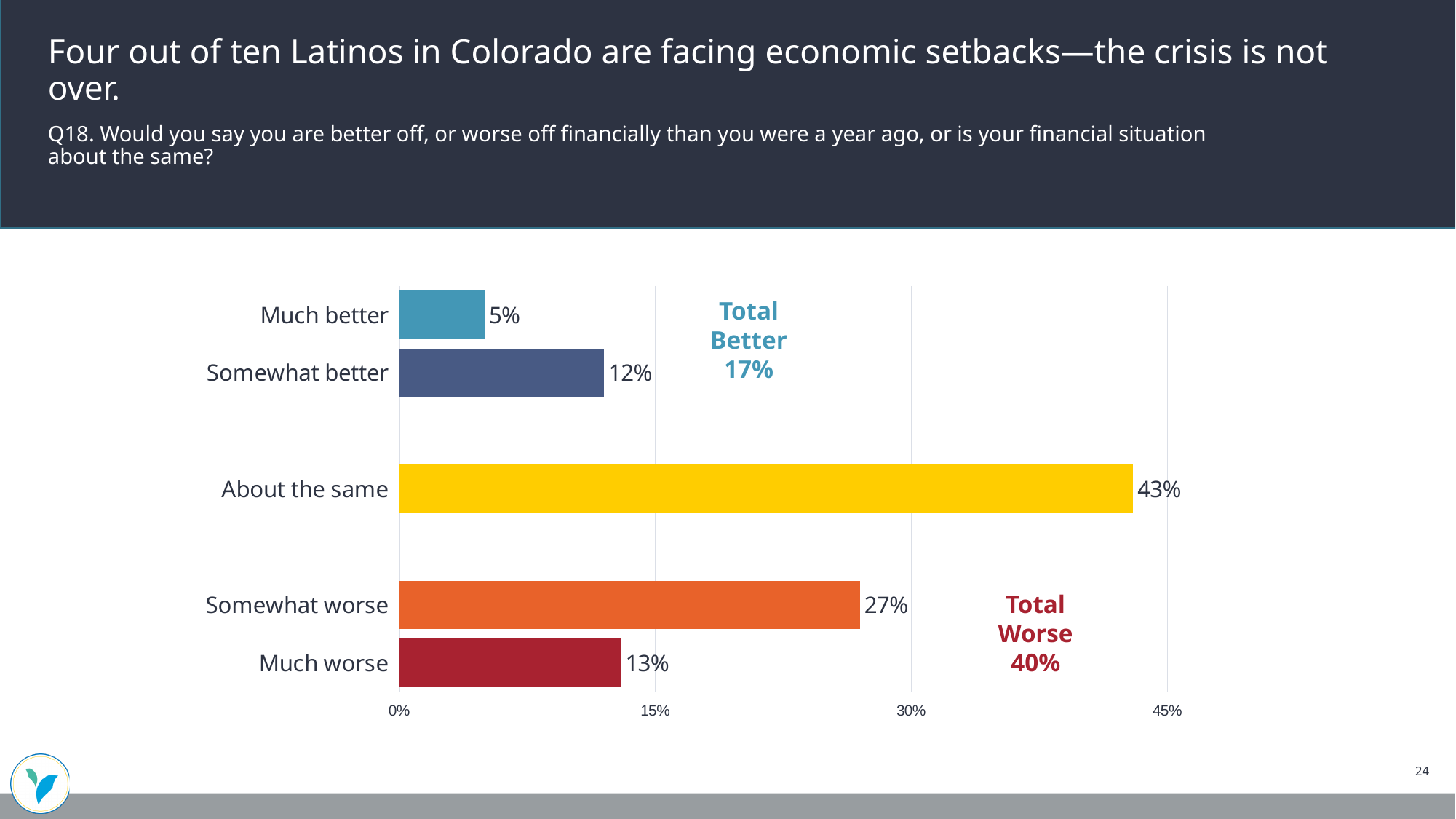
What is the 'Total Worse' percentage annotated on the chart? 40% How many categories are shown in the chart? 5 What is the difference between 'Somewhat worse' and 'Somewhat better'? 15% Is the value for 'About the same' greater or less than 30%? greater Which is larger, 'Much worse' or 'Somewhat better'? Much worse Which category has the lowest value? Much better What is the value for 'About the same'? 43% What is the value for 'Much worse'? 13% What percentage of respondents said they are 'Much better' off financially? 5% What kind of chart is shown on the slide? Bar chart Which category has the highest value? About the same What is the value for 'Somewhat worse'? 27%